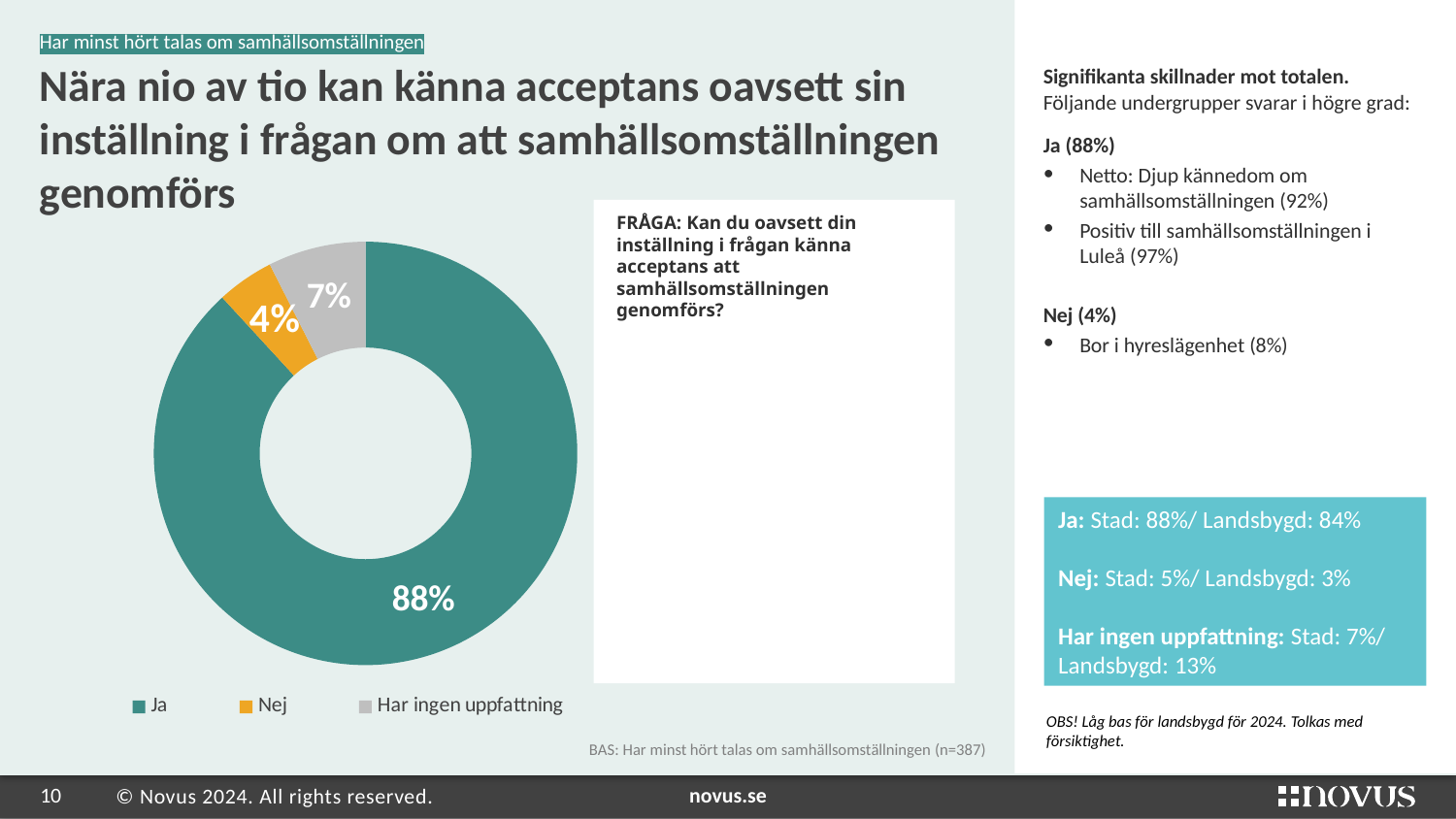
What colour is used for the "Nej" slice in the donut chart? Orange How many entries does the chart legend list? 3 What percentage of respondents answered "Nej" in the donut chart? 4% What is the difference in percentage points between the "Har ingen uppfattning" and "Nej" slices? 3 Which response category has the smallest share in the donut chart? Nej What type of chart is shown on the slide? Donut (pie) chart What percentage of respondents answered "Har ingen uppfattning" in the donut chart? 7% Which slice is larger: "Nej" or "Har ingen uppfattning"? Har ingen uppfattning Which response category has the largest share in the donut chart? Ja How many response categories are shown in the donut chart? 3 What is the difference in percentage points between the "Ja" and "Nej" slices? 84 What percentage of respondents answered "Ja" in the donut chart? 88%